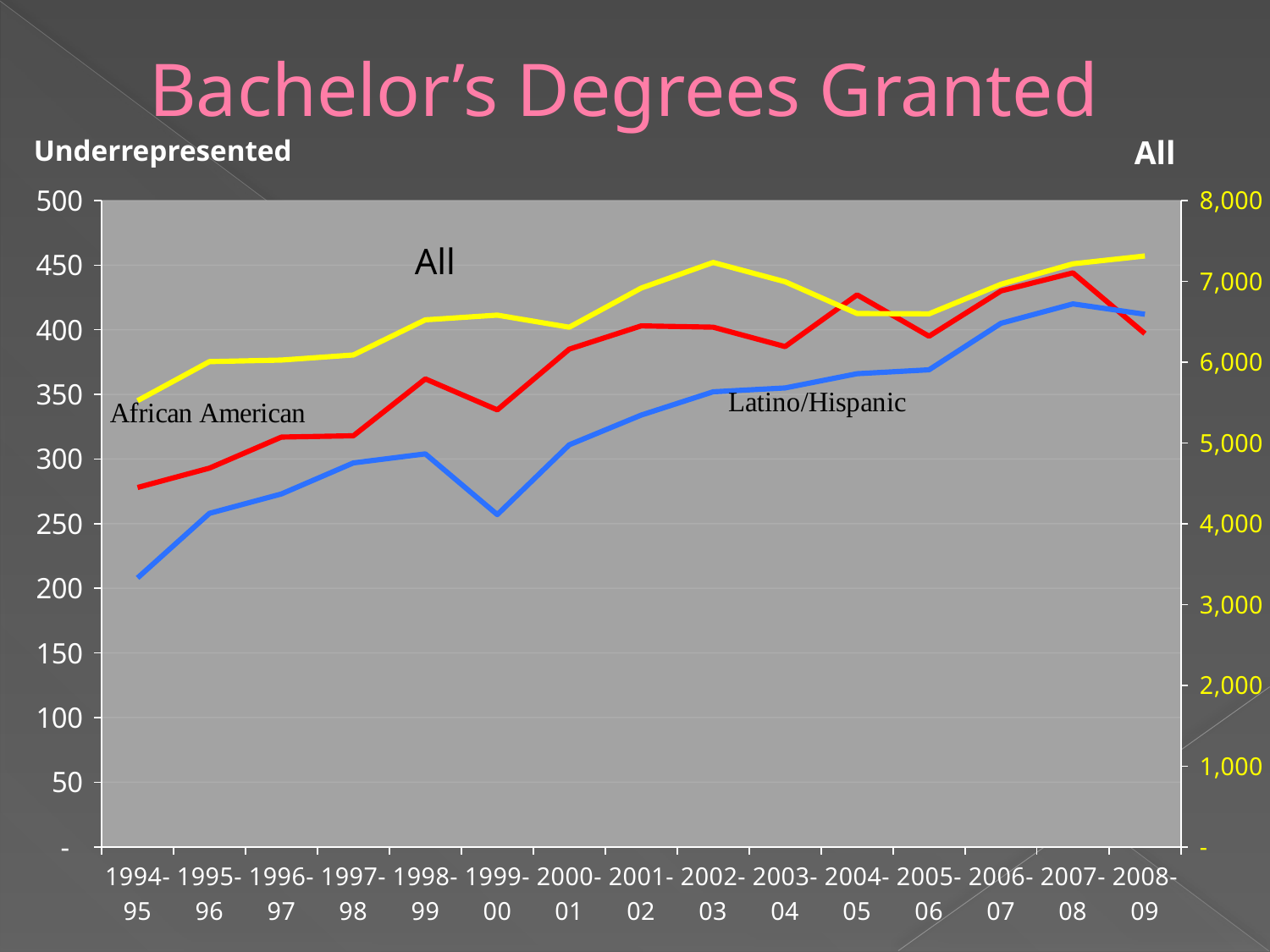
Is the value for All in 2008-09 greater or less than 7,000 on the right-hand axis? greater In 1994-95, which is larger: the African American value or the Latino/Hispanic value? African American What kind of chart is shown on the slide? line chart Is the value for African American in 2007-08 greater or less than 400? greater What is the title of the chart? Bachelor's Degrees Granted Is the value for African American in 1994-95 greater or less than 300? less How many academic years are plotted along the x axis? 15 In which academic year is the Latino/Hispanic line at its lowest? 1994-95 Does the Latino/Hispanic line generally rise or fall from 1994-95 to 2008-09? rise In which academic year does the All line reach its highest value? 2008-09 How many lines (series) are plotted on the chart? 3